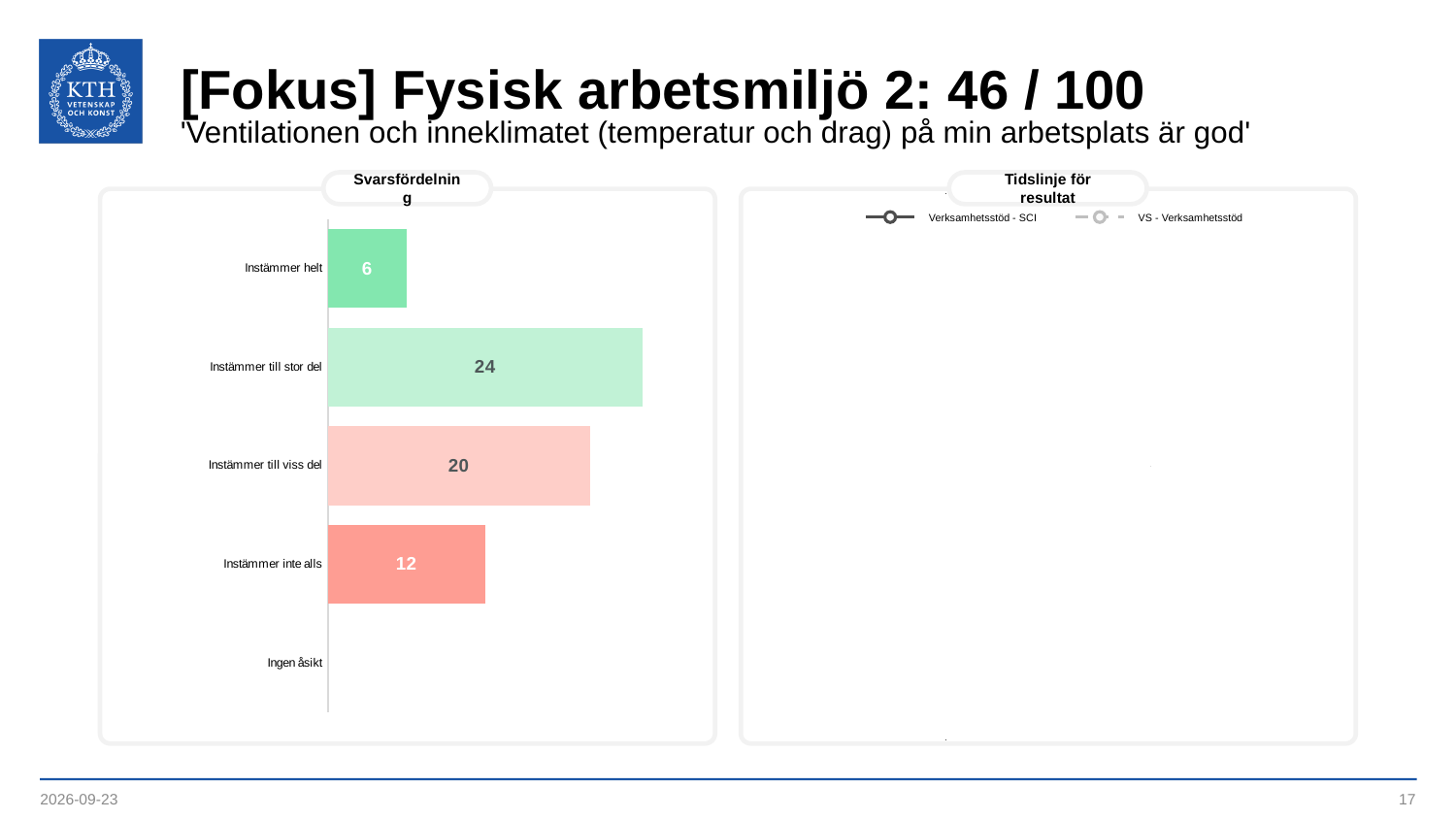
In the 'Svarsfördelning' chart, what is the value for 'Instämmer till stor del'? 24 What are the two legend entries in the 'Tidslinje för resultat' chart? Verksamhetsstöd - SCI and VS - Verksamhetsstöd In the 'Svarsfördelning' chart, which is larger: 'Instämmer inte alls' or 'Instämmer helt'? Instämmer inte alls In the 'Svarsfördelning' chart, which category has the highest value? Instämmer till stor del How many series does the legend of the 'Tidslinje för resultat' chart list? 2 In the 'Svarsfördelning' chart, what is the value for 'Instämmer inte alls'? 12 In the 'Svarsfördelning' chart, what is the difference between 'Instämmer till stor del' and 'Instämmer till viss del'? 4 In the 'Svarsfördelning' chart, what is the value for 'Instämmer helt'? 6 How many categories are listed on the axis of the 'Svarsfördelning' chart? 5 In the 'Svarsfördelning' chart, what is the difference between 'Instämmer till viss del' and 'Instämmer inte alls'? 8 What kind of chart is the 'Svarsfördelning' chart? Bar chart In the 'Svarsfördelning' chart, what is the value for 'Instämmer till viss del'? 20